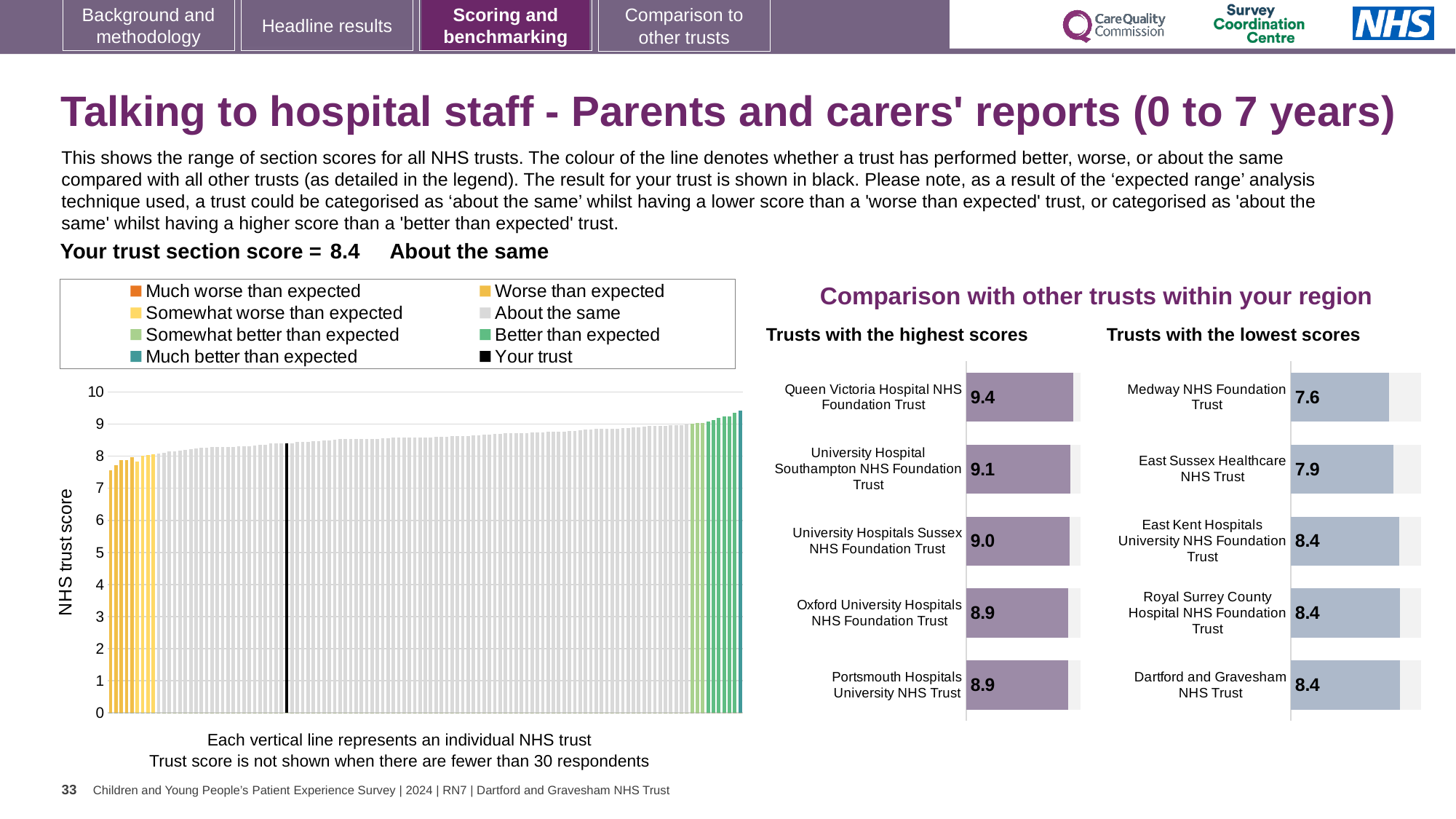
What kind of chart is the NHS trust score chart on the left of the slide? Bar chart In the 'Trusts with the highest scores' chart, which has the higher score: Oxford University Hospitals NHS Foundation Trust or University Hospitals Sussex NHS Foundation Trust? University Hospitals Sussex NHS Foundation Trust In the 'Trusts with the highest scores' chart, which trust has the highest score? Queen Victoria Hospital NHS Foundation Trust In the 'Trusts with the lowest scores' chart, which trust has the lowest score? Medway NHS Foundation Trust In the NHS trust score chart on the left, is the value for your trust (the black bar) greater or less than 5? greater How many trusts are shown in the 'Trusts with the lowest scores' chart? 5 In the NHS trust score chart on the left, do the values rise or fall from left to right? Rise How many entries does the legend of the NHS trust score chart on the left list? 8 In the 'Trusts with the highest scores' chart, what is the score for Queen Victoria Hospital NHS Foundation Trust? 9.4 In the 'Trusts with the lowest scores' chart, how much higher is East Sussex Healthcare NHS Trust's score than Medway NHS Foundation Trust's? 0.3 In the 'Trusts with the highest scores' chart, what is the difference between the scores of Queen Victoria Hospital NHS Foundation Trust and University Hospital Southampton NHS Foundation Trust? 0.3 In the 'Trusts with the lowest scores' chart, what is the score for Medway NHS Foundation Trust? 7.6